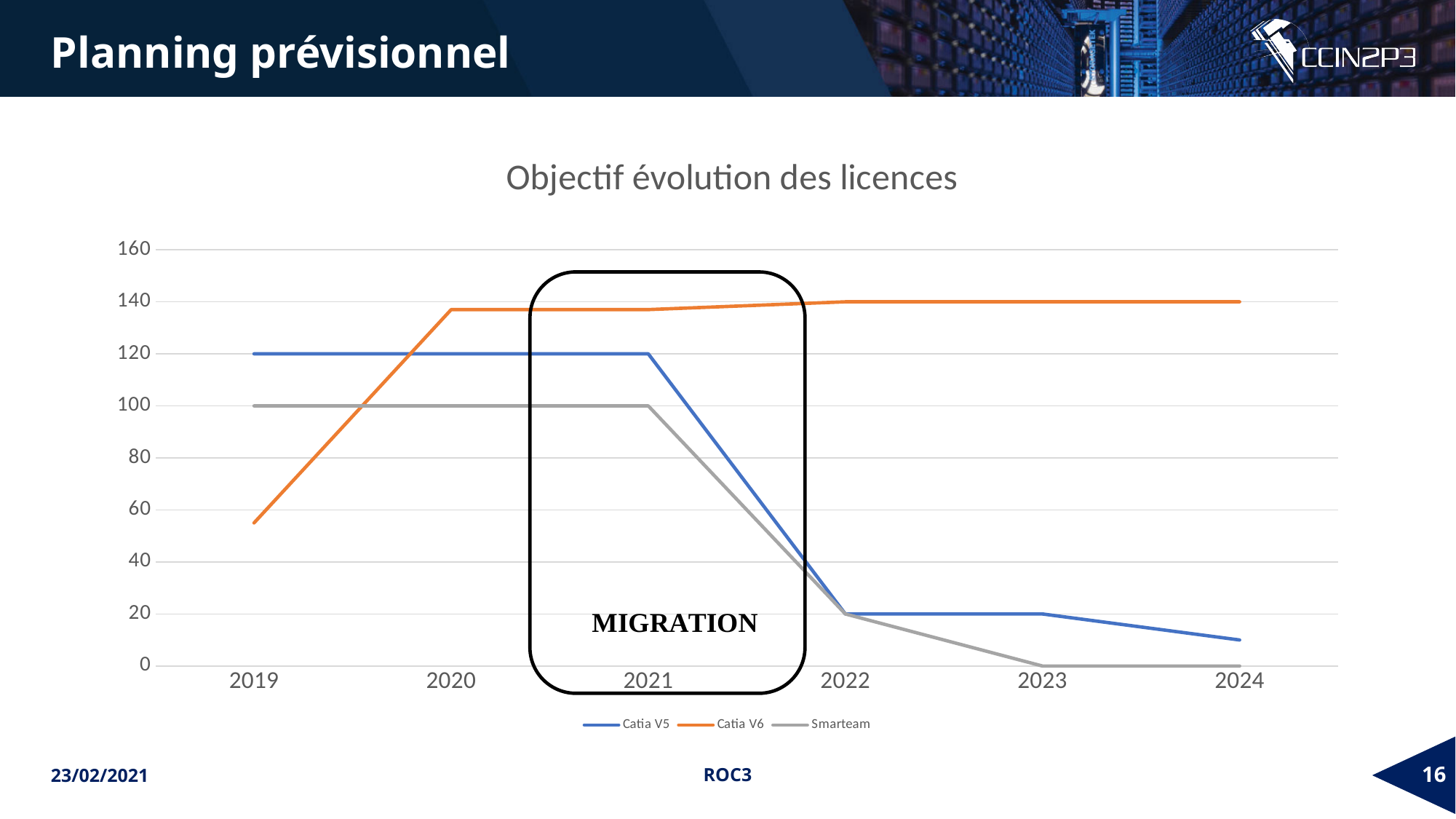
Which series has the highest value in 2024? Catia V6 Is the value for Catia V6 in 2020 greater or less than 120? greater What is the value for Catia V5 in 2022? 20 How many series does the legend list? 3 What is the value for Smarteam in 2023? 0 Does the Catia V5 line rise or fall from 2021 to 2022? fall Is the value for Catia V6 in 2019 greater or less than 60? less What type of chart is shown on the slide? line chart How many years are shown on the x axis? 6 What is the value for Smarteam in 2020? 100 What is the title of the chart? Objectif évolution des licences What is the value for Catia V5 in 2019? 120